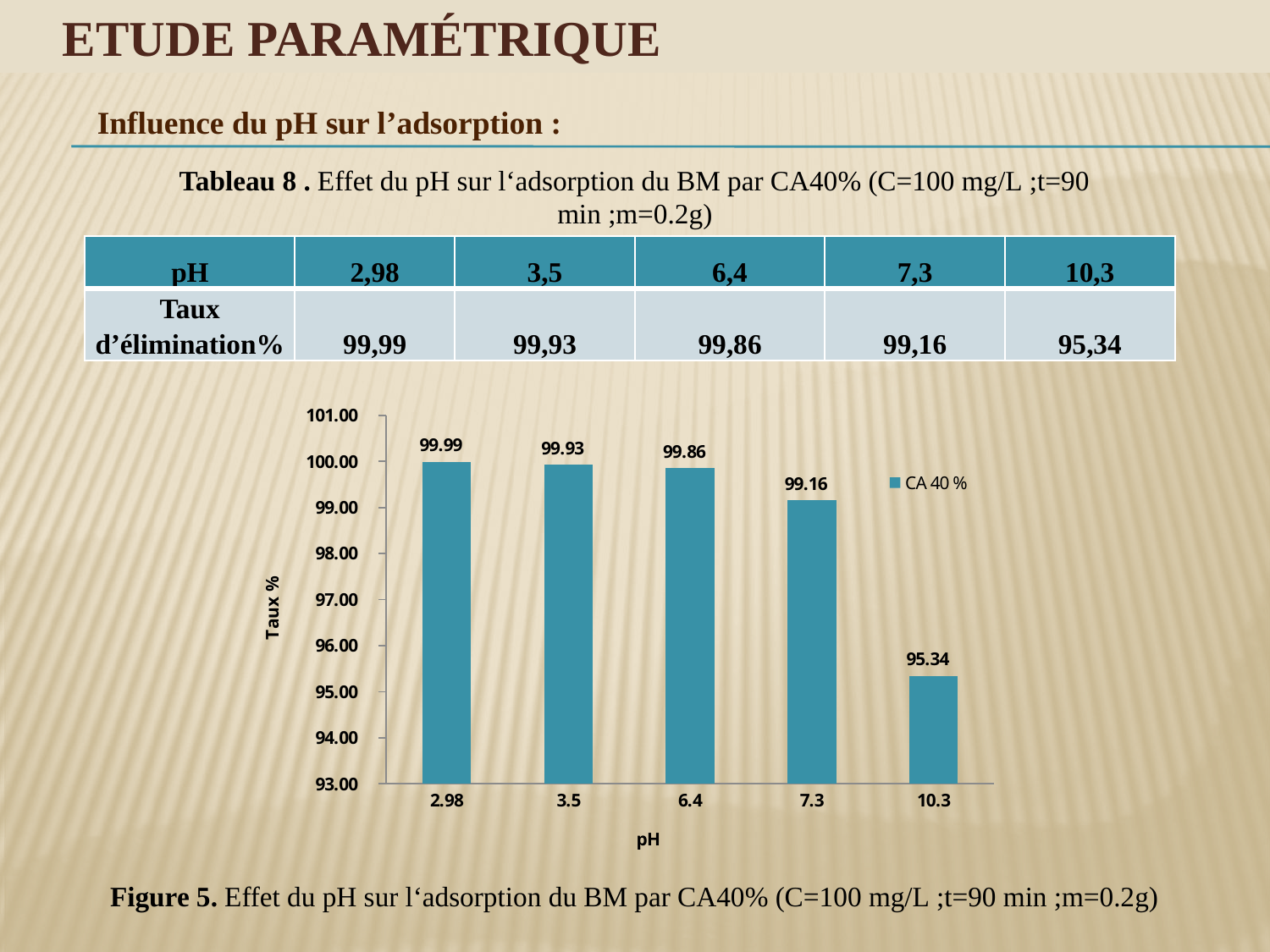
What kind of chart is shown on the slide? bar chart What is the value for pH 10.3 in the chart? 95.34 Which is larger, the value for pH 7.3 or the value for pH 10.3? pH 7.3 How many pH categories are shown in the chart? 5 What is the difference between the values for pH 2.98 and pH 10.3? 4.65 Is the value for pH 10.3 greater or less than 96.00? less Which pH has the highest value in the chart? 2.98 What is the value for pH 7.3 in the chart? 99.16 What series name does the chart legend show? CA 40 % Which pH has the lowest value in the chart? 10.3 What is the difference between the values for pH 6.4 and pH 7.3? 0.70 What is the value for pH 2.98 in the chart? 99.99